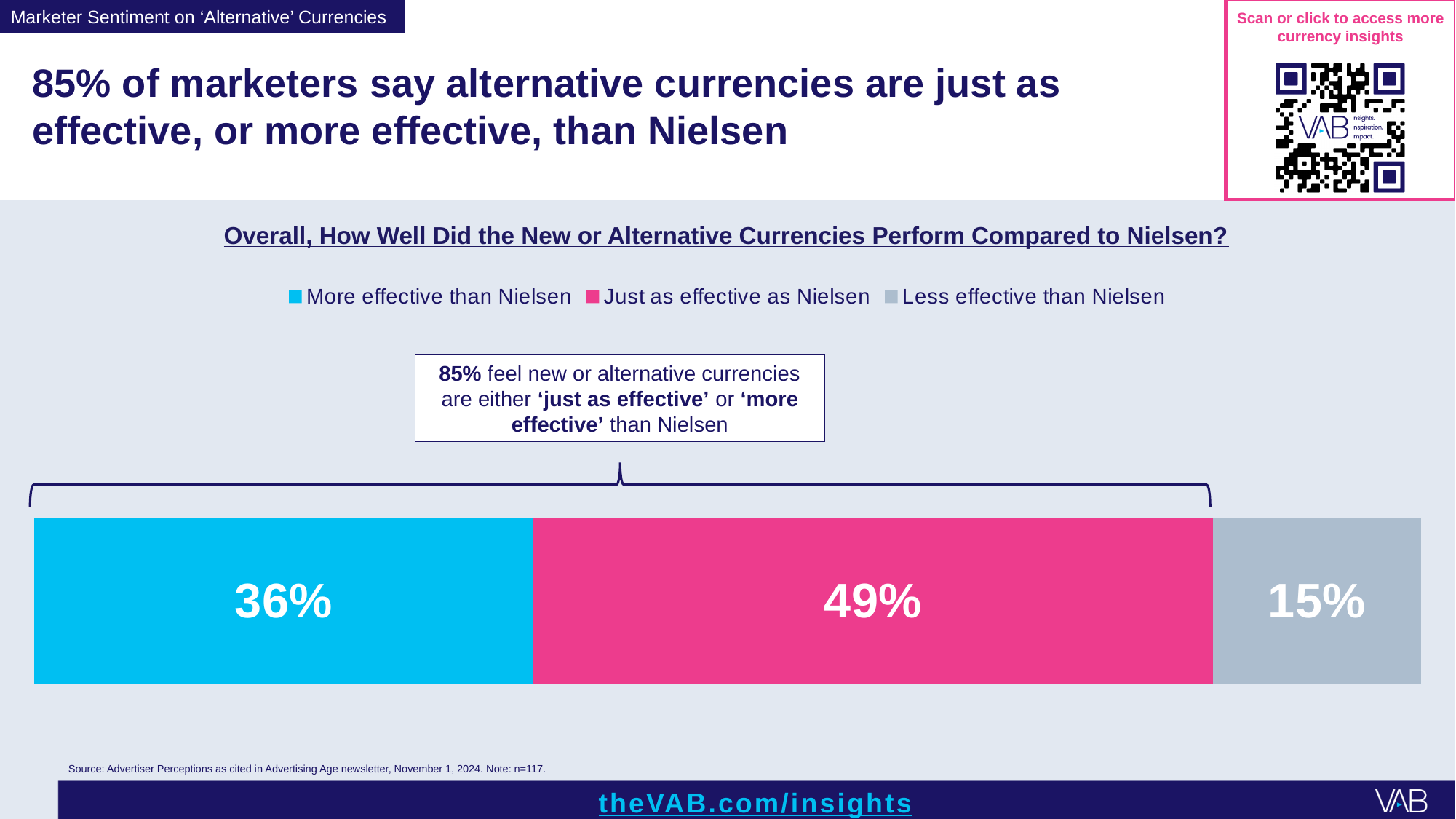
What is the title of the chart? Overall, How Well Did the New or Alternative Currencies Perform Compared to Nielsen? What kind of chart is shown on the slide? Stacked bar chart Which response has the smallest share in the chart? Less effective than Nielsen What percentage of marketers said alternative currencies were less effective than Nielsen? 15% What percentage of marketers said alternative currencies were more effective than Nielsen? 36% What percentage of marketers said alternative currencies were just as effective as Nielsen? 49% What is the difference between the 'Just as effective as Nielsen' share and the 'More effective than Nielsen' share? 13% How many series does the legend list? 3 Which is larger: the share for 'More effective than Nielsen' or the share for 'Less effective than Nielsen'? More effective than Nielsen What is the combined share of 'More effective than Nielsen' and 'Just as effective as Nielsen'? 85% Which response has the largest share in the chart? Just as effective as Nielsen What colour represents 'Just as effective as Nielsen' in the chart? Pink